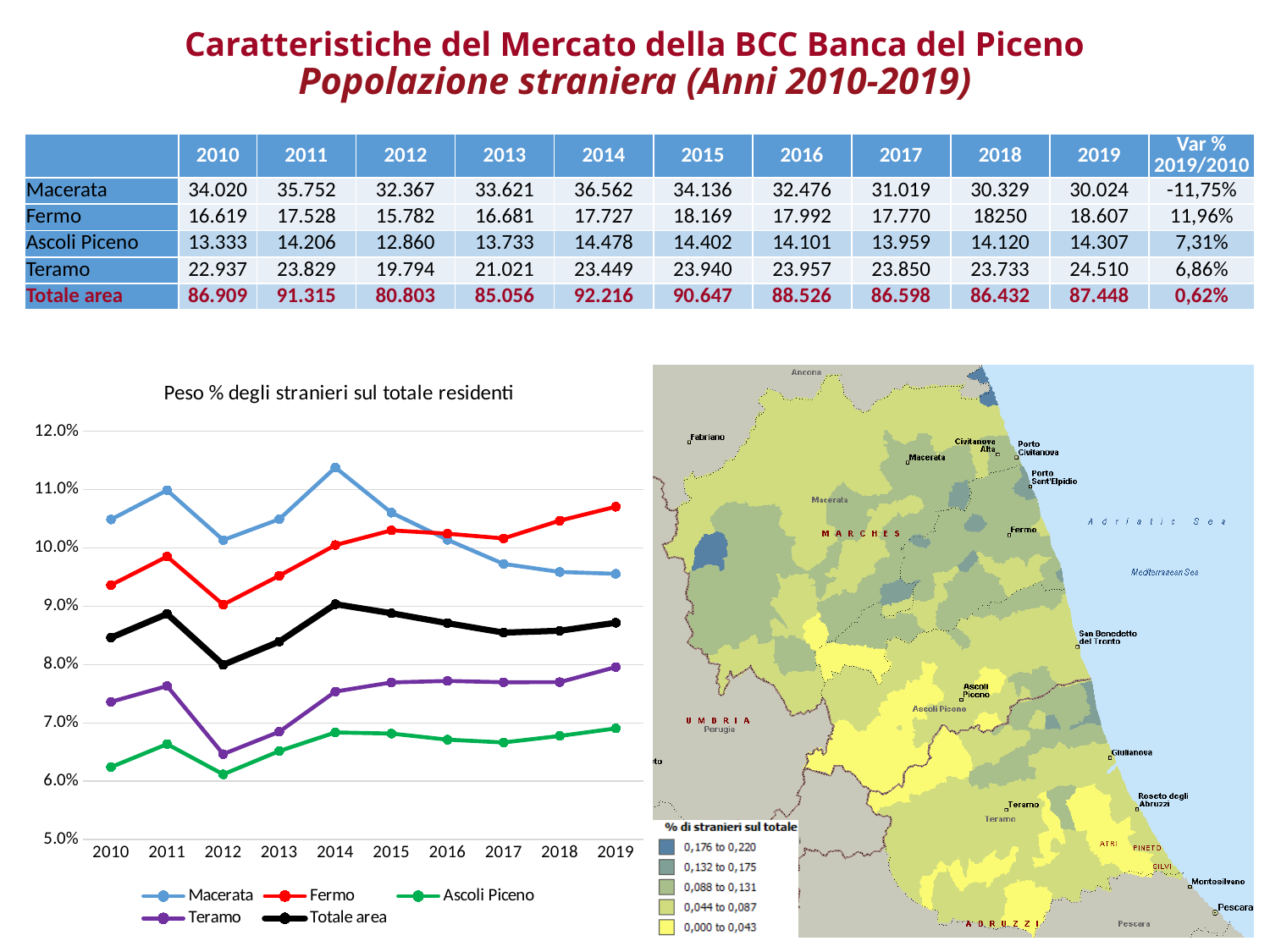
In the line chart "Peso % degli stranieri sul totale residenti", what colour is the Totale area line? black In the line chart "Peso % degli stranieri sul totale residenti", is the value for Ascoli Piceno in 2010 greater or less than 7.0%? less In the line chart "Peso % degli stranieri sul totale residenti", which series has the highest value in 2019? Fermo How many series does the legend of the line chart "Peso % degli stranieri sul totale residenti" list? 5 In the line chart "Peso % degli stranieri sul totale residenti", which is larger in 2019: Teramo or Ascoli Piceno? Teramo In the line chart "Peso % degli stranieri sul totale residenti", which series has the highest value in 2010? Macerata In the line chart "Peso % degli stranieri sul totale residenti", is the value for Macerata in 2014 greater or less than 11.0%? greater How many years are plotted along the x axis of the line chart "Peso % degli stranieri sul totale residenti"? 10 In the line chart "Peso % degli stranieri sul totale residenti", is the value for Teramo in 2012 greater or less than 7.0%? less What kind of chart is the chart titled "Peso % degli stranieri sul totale residenti"? line chart In the line chart "Peso % degli stranieri sul totale residenti", which series has the lowest value in 2019? Ascoli Piceno In the line chart "Peso % degli stranieri sul totale residenti", does the Macerata series rise or fall from 2014 to 2019? fall